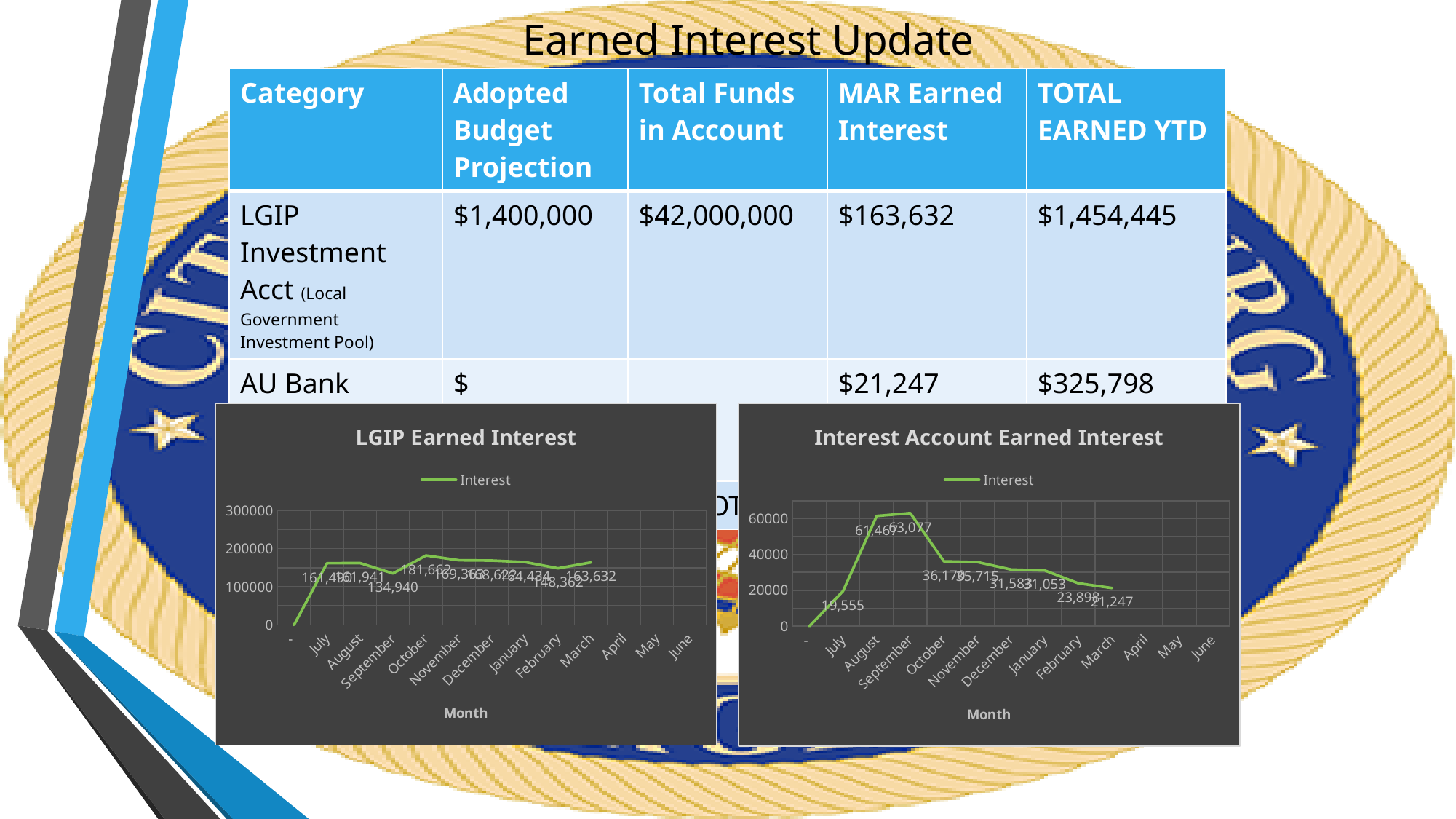
In the 'LGIP Earned Interest' chart, what is the value for September? 134,940 How many series does the legend of the 'Interest Account Earned Interest' chart list? 1 What kind of chart is the 'LGIP Earned Interest' chart? line chart In the 'Interest Account Earned Interest' chart, what is the difference between the September and August values? 1,610 In the 'LGIP Earned Interest' chart, which is larger, the value for February or the value for March? March In the 'Interest Account Earned Interest' chart, what is the value for July? 19,555 In the 'LGIP Earned Interest' chart, which month has the highest value? October In the 'LGIP Earned Interest' chart, what is the value for October? 181,662 In the 'Interest Account Earned Interest' chart, what is the value for March? 21,247 In the 'Interest Account Earned Interest' chart, which month has the highest value? September In the 'Interest Account Earned Interest' chart, is the value for October greater or less than 40000? less In the 'Interest Account Earned Interest' chart, do the values rise or fall from September to March? fall